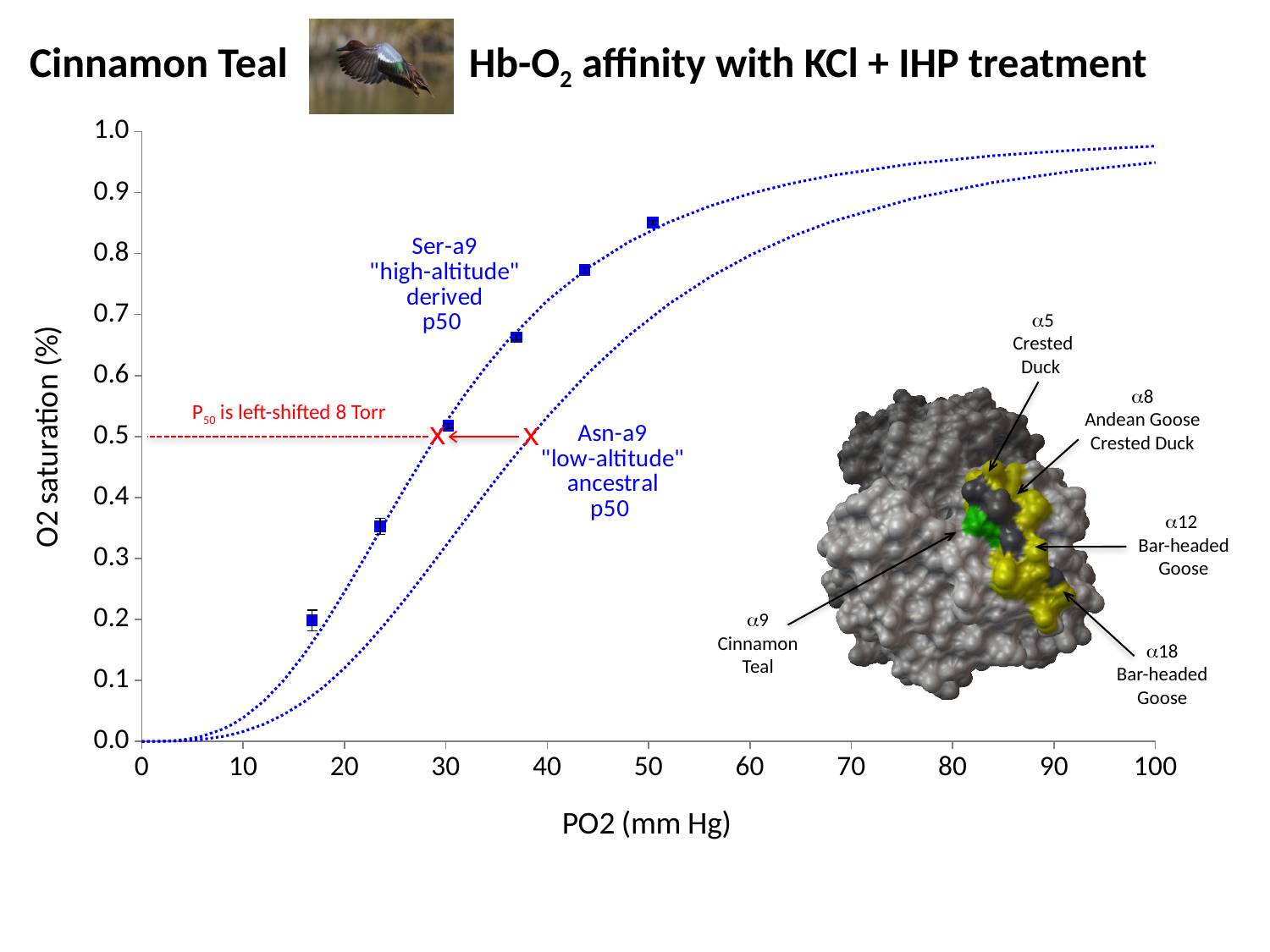
What is the maximum value shown on the x axis of the chart? 100 At what O2 saturation level is the red dashed P50 line drawn? 0.5 Is the O2 saturation of the data point plotted near PO2 = 37 greater or less than 0.6? greater What kind of chart is shown on the slide? Line chart with data points (scatter with fitted curves) Do the plotted O2 saturation values rise or fall as PO2 increases along the x axis? Rise Is the O2 saturation of the leftmost data point (near PO2 = 17) greater or less than 0.3? less What is the label of the x axis of the chart? PO2 (mm Hg) Is the O2 saturation of the data point plotted near PO2 = 50 greater or less than 0.8? greater What is the label of the y axis of the chart? O2 saturation (%) Which curve has the lower p50: the Ser-a9 "high-altitude" derived curve or the Asn-a9 "low-altitude" ancestral curve? Ser-a9 "high-altitude" derived How many blue square data points are plotted on the chart? 6 By how many Torr is P50 left-shifted according to the annotation on the chart? 8 Torr